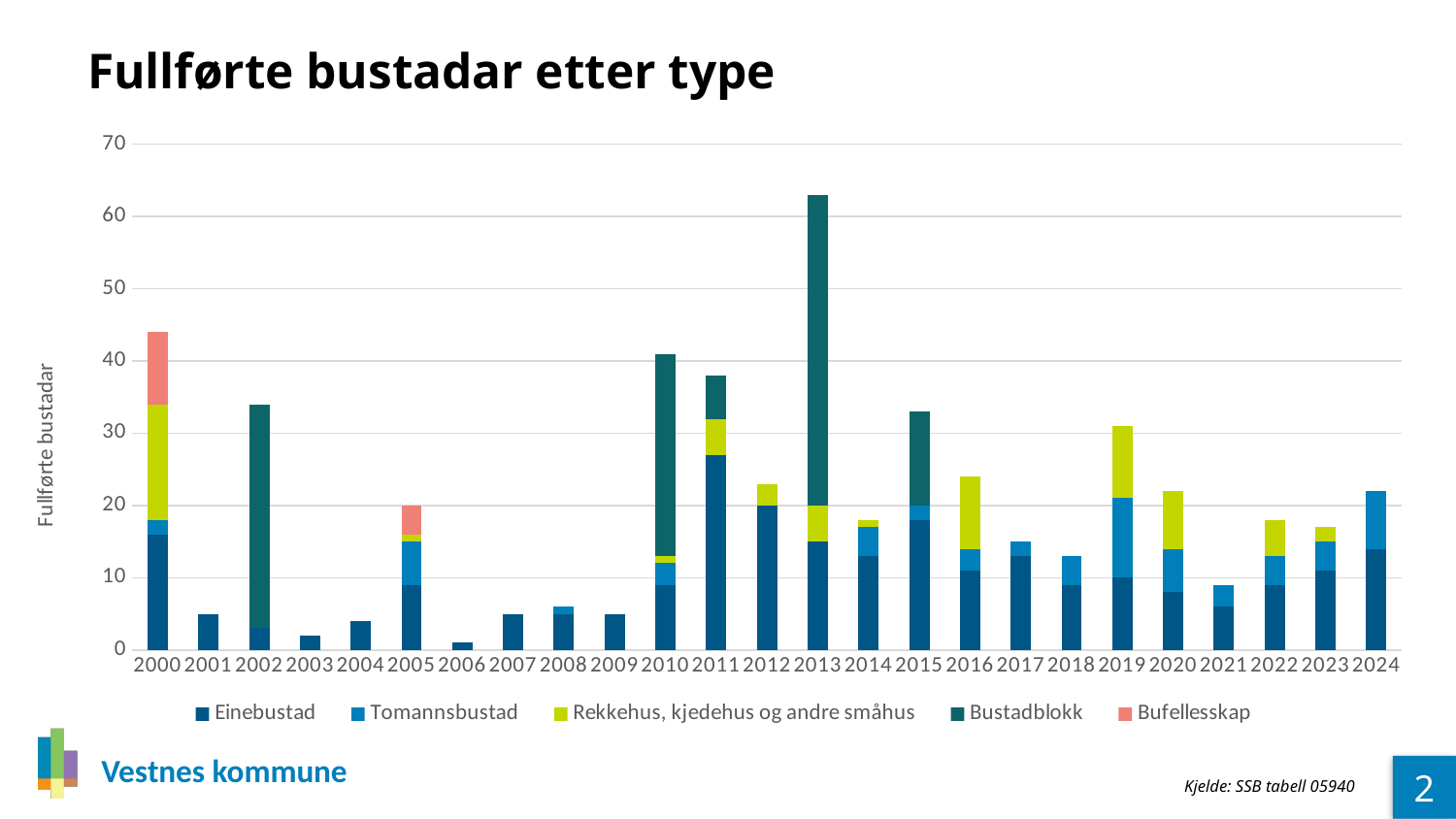
What kind of chart is shown on the slide? Stacked bar chart Which series is shown in the light red/salmon colour in the legend? Bufellesskap Which year has the larger total, 2002 or 2005? 2002 How many series does the legend list? 5 Is the total value for 2000 greater or less than 40? greater Which year has the highest total of completed dwellings? 2013 Is the total value for 2013 greater or less than 60? greater What is the title of the chart? Fullførte bustadar etter type Which year has the lowest total of completed dwellings? 2006 Is the total value for 2024 greater or less than 20? greater How many years are shown along the x axis? 25